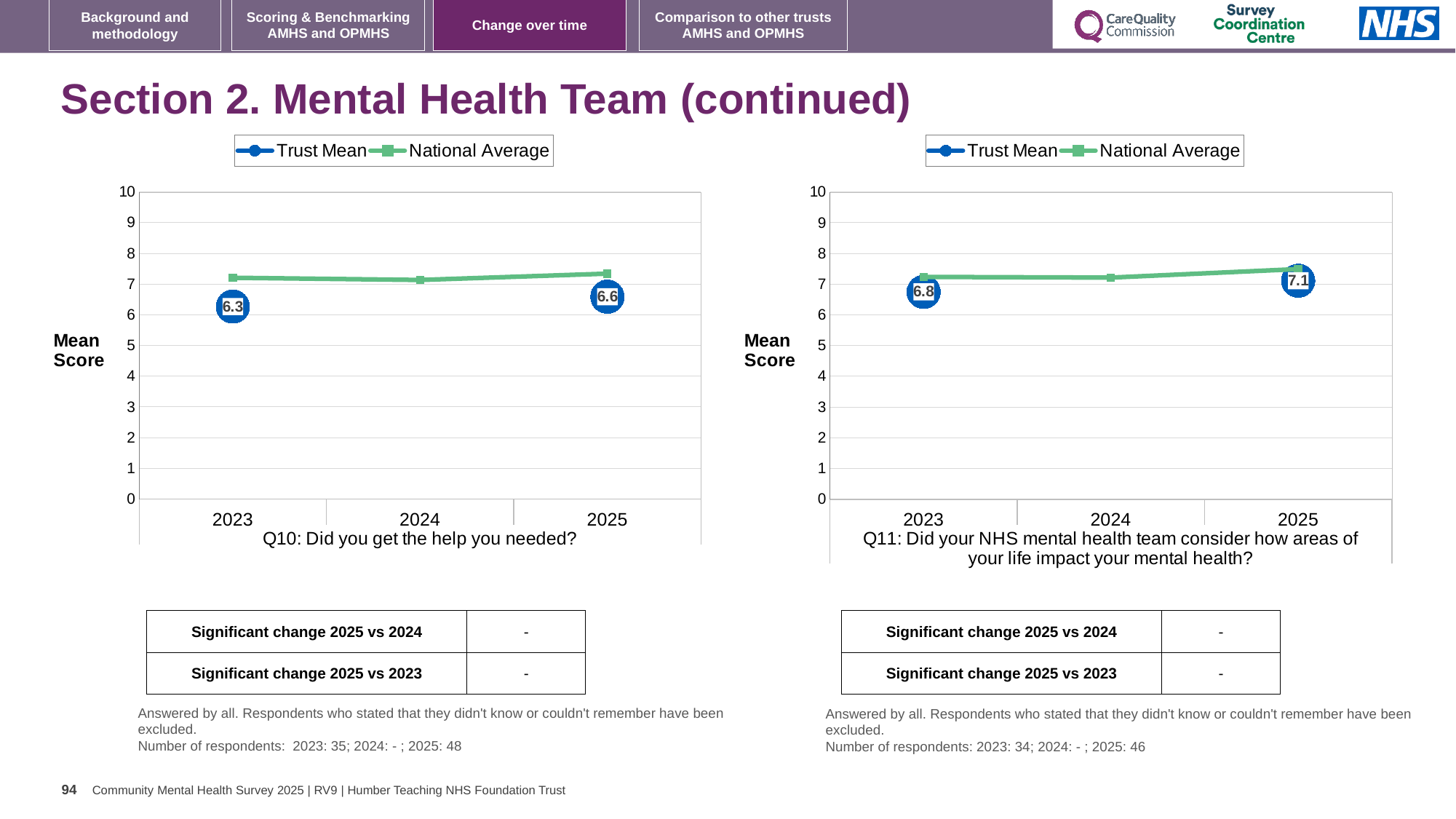
In the Q10 chart (left), what is the Trust Mean for 2023? 6.3 In the Q10 chart (left), is the Trust Mean higher in 2023 or 2025? 2025 How many series does the legend of the Q11 chart (right) list? 2 In the Q10 chart (left), what is the Trust Mean for 2025? 6.6 In the Q11 chart (right), is the National Average for 2025 greater or less than 6? greater How many years are shown on the x axis of the Q11 chart (right)? 3 In the Q10 chart (left), by how much did the Trust Mean change from 2023 to 2025? 0.3 In the Q11 chart (right), what is the Trust Mean for 2023? 6.8 What kind of chart is the Q10 chart (left)? Line chart In the Q11 chart (right), by how much did the Trust Mean change from 2023 to 2025? 0.3 In the Q10 chart (left), is the Trust Mean for 2023 greater or less than 7? less In the Q11 chart (right), what is the Trust Mean for 2025? 7.1